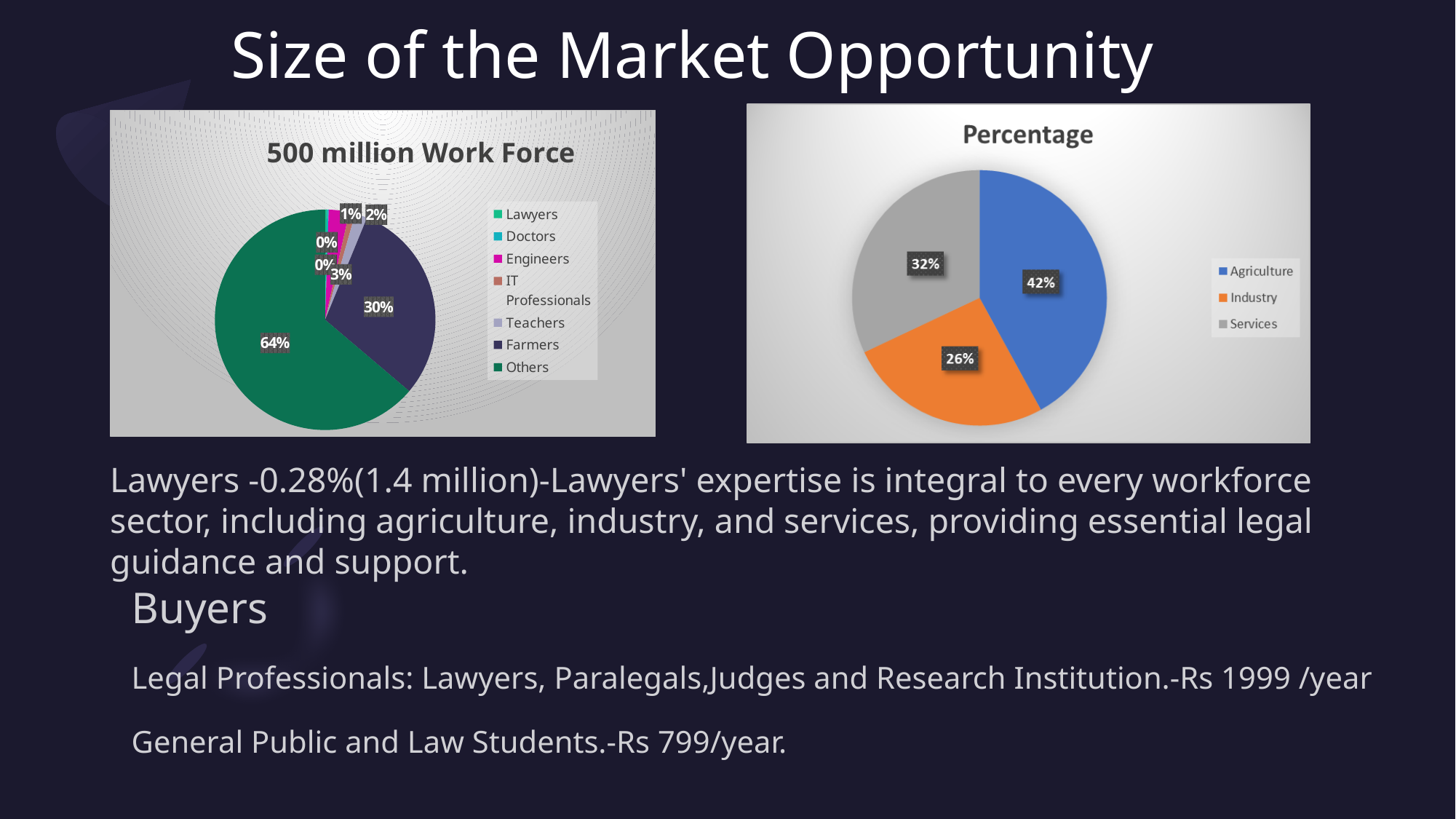
In the 'Percentage' pie chart, what share is labelled for Services? 32% In the '500 million Work Force' pie chart, which category has the largest slice? Others What kind of chart is the chart titled 'Percentage'? Pie chart How many categories does the legend of the '500 million Work Force' chart list? 7 In the 'Percentage' pie chart, which category has the largest slice? Agriculture In the 'Percentage' pie chart, what share is labelled for Industry? 26% In the '500 million Work Force' pie chart, what share is labelled for Engineers? 3% In the 'Percentage' pie chart, which category has the smallest slice? Industry In the 'Percentage' pie chart, what share is labelled for Agriculture? 42% In the 'Percentage' pie chart, what is the difference in percentage points between Agriculture and Industry? 16 In the '500 million Work Force' pie chart, what share is labelled for Others? 64% In the '500 million Work Force' pie chart, what share is labelled for Farmers? 30%